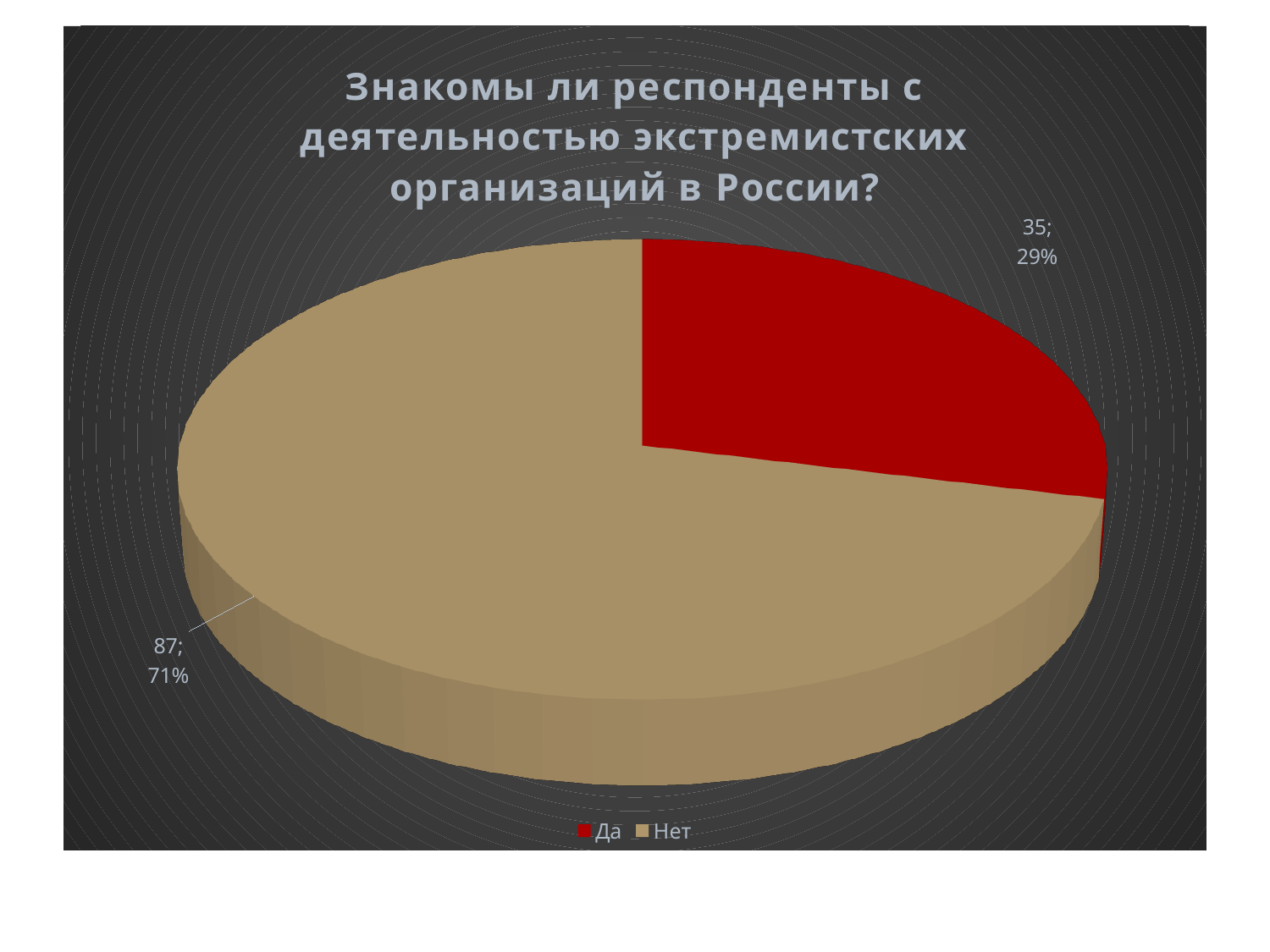
What share of the pie does the 'Нет' slice represent? 71% Which colour represents the 'Да' slice? red How many entries does the legend list? 2 What is the title of the chart? Знакомы ли респонденты с деятельностью экстремистских организаций в России? How many slices does the pie chart have? 2 What kind of chart is shown on the slide? pie chart Which slice is the largest? Нет What share of the pie does the 'Да' slice represent? 29% Which slice is the smallest? Да What is the difference between the counts for 'Нет' and 'Да'? 52 What is the count for the 'Нет' slice? 87 What is the count for the 'Да' slice? 35